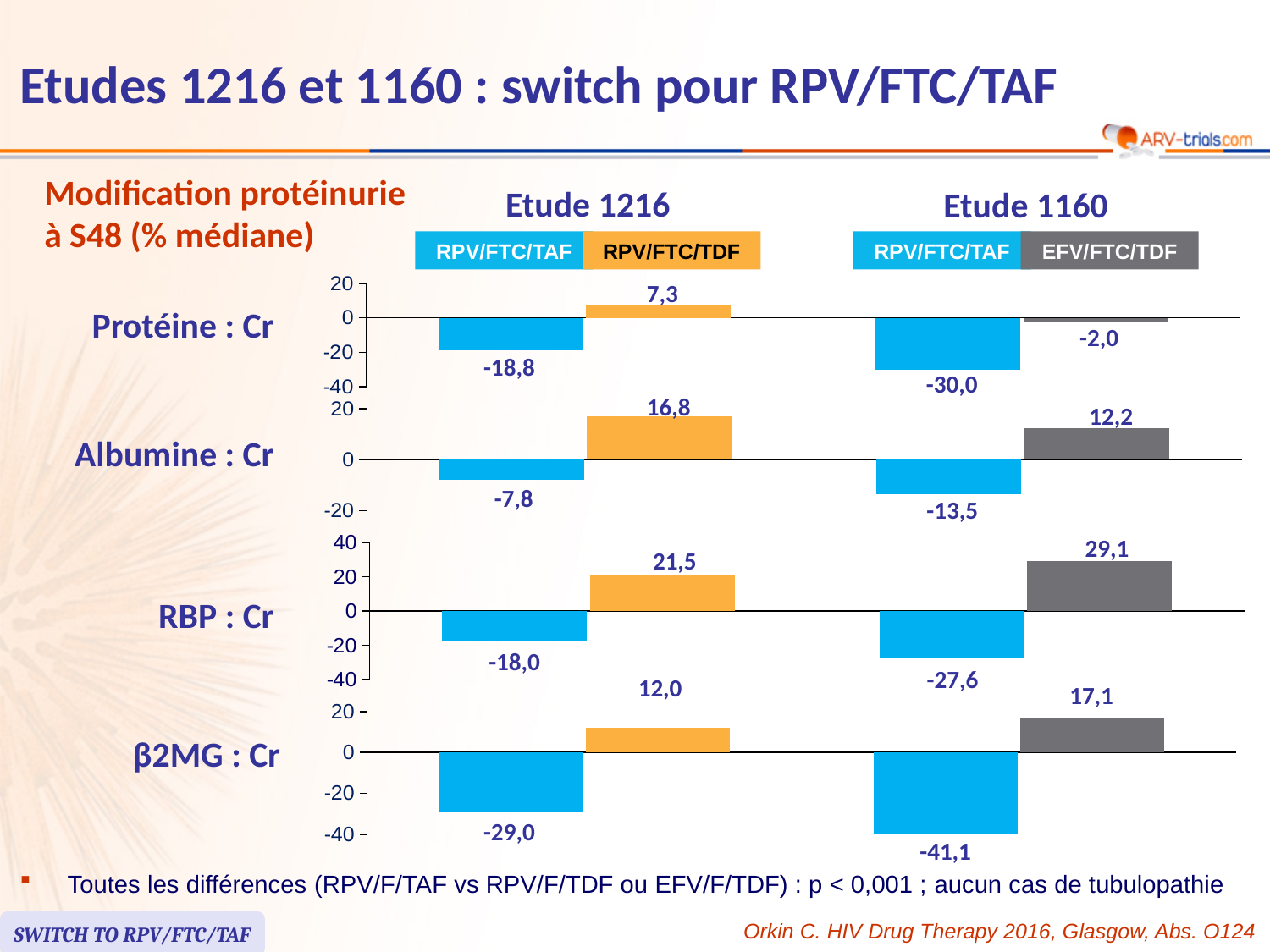
In the Albumine : Cr chart, which is larger: the RPV/FTC/TDF value in Etude 1216 or the EFV/FTC/TDF value in Etude 1160? RPV/FTC/TDF in Etude 1216 In the Protéine : Cr chart, what is the value for RPV/FTC/TAF in Etude 1216? -18,8 Which two arms are compared in Etude 1160? RPV/FTC/TAF and EFV/FTC/TDF In the β2MG : Cr chart, which arm has the lowest value across both studies? RPV/FTC/TAF (Etude 1160) In the RBP : Cr chart, which arm has the highest value across both studies? EFV/FTC/TDF (Etude 1160) In the β2MG : Cr chart, what is the value for EFV/FTC/TDF in Etude 1160? 17,1 In the Albumine : Cr chart, what is the value for RPV/FTC/TDF in Etude 1216? 16,8 In the RBP : Cr chart, what is the value for RPV/FTC/TAF in Etude 1160? -27,6 In the Protéine : Cr chart, what is the difference between the RPV/FTC/TDF value and the RPV/FTC/TAF value in Etude 1216? 26,1 What type of chart is used to show the proteinuria changes on this slide? Bar chart In the β2MG : Cr chart, is the value for RPV/FTC/TAF in Etude 1160 greater or less than -40? less In the Protéine : Cr chart, what is the value for EFV/FTC/TDF in Etude 1160? -2,0